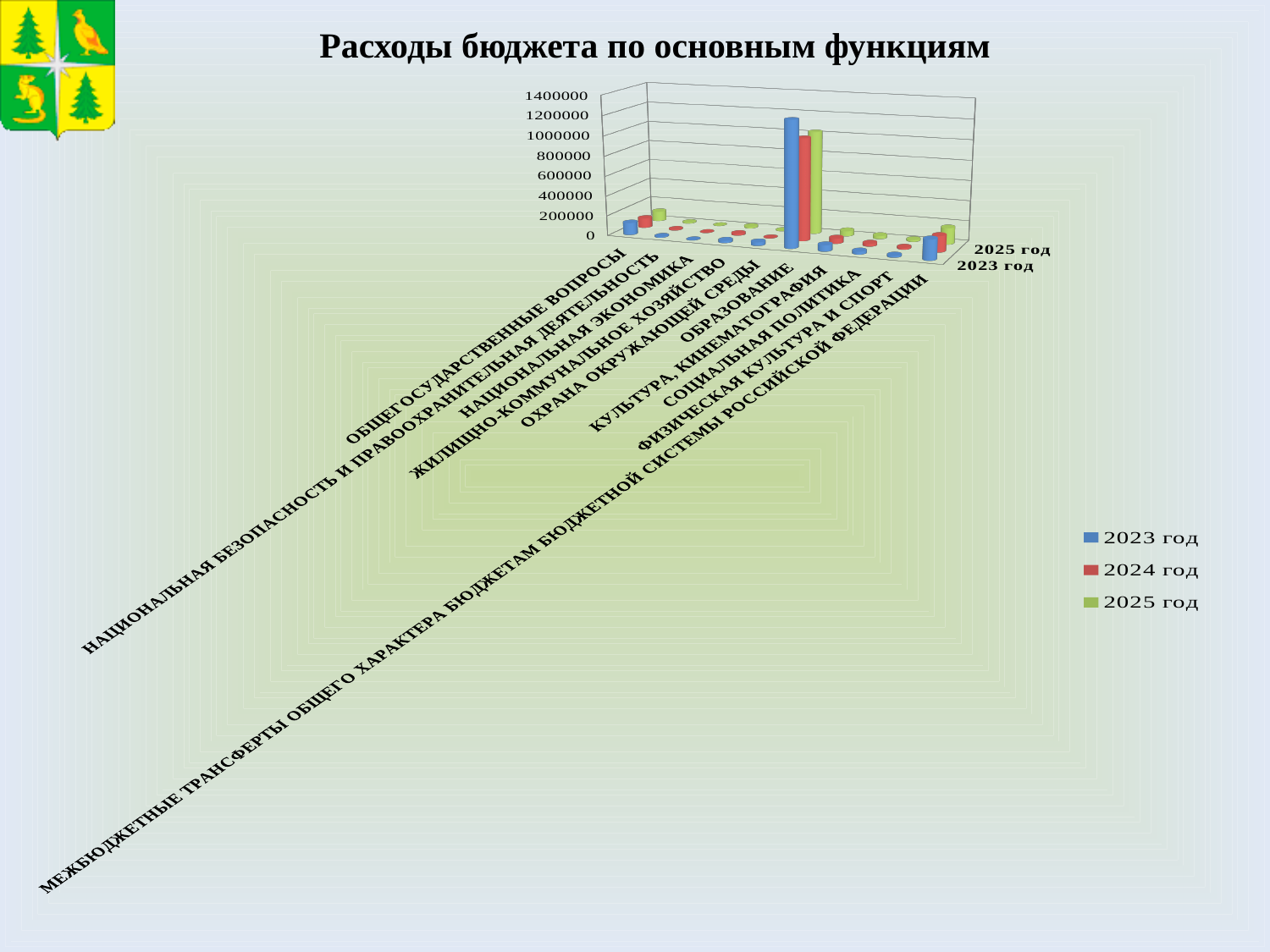
Is the value for ОБЩЕГОСУДАРСТВЕННЫЕ ВОПРОСЫ in 2023 год greater or less than 400000? less Which is larger: the 2023 год value for ОБРАЗОВАНИЕ or the 2023 год value for ОХРАНА ОКРУЖАЮЩЕЙ СРЕДЫ? ОБРАЗОВАНИЕ How many series does the legend list? 3 Is the value for ОБРАЗОВАНИЕ in 2023 год greater or less than 600000? greater What is the highest value shown on the vertical axis of the chart? 1400000 What is the title of the chart? Расходы бюджета по основным функциям What kind of chart is shown on the slide? bar chart Which years are listed in the chart legend? 2023 год, 2024 год, 2025 год How many categories are shown along the category axis of the chart? 10 Which category has the highest bars in the chart? ОБРАЗОВАНИЕ Is the value for ОБРАЗОВАНИЕ in 2025 год greater or less than 400000? greater